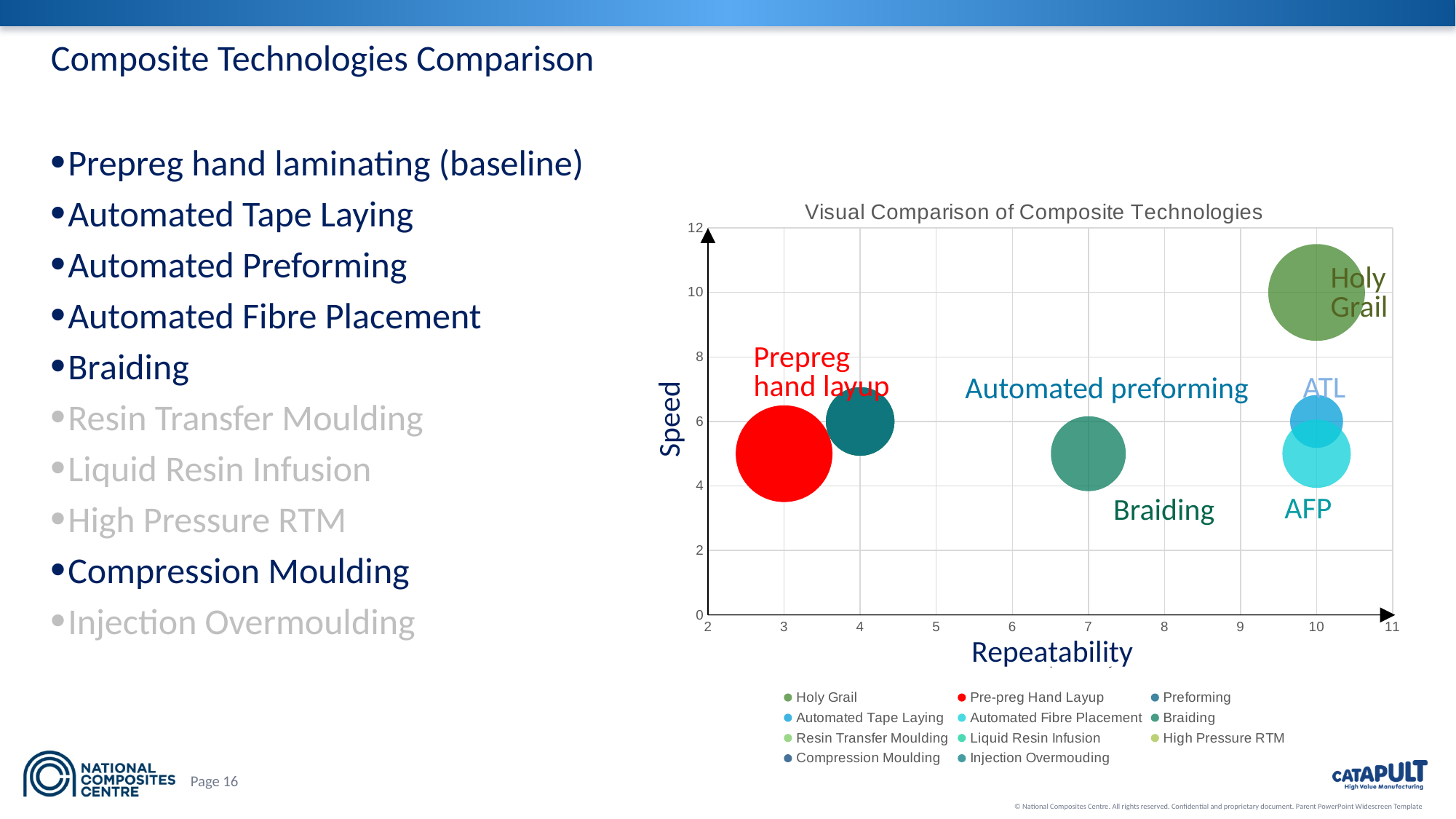
Which has the higher Repeatability value, Braiding or Prepreg hand layup? Braiding What is the Speed value for the Holy Grail bubble? 10 What is the title of the chart? Visual Comparison of Composite Technologies How many bubbles are plotted on the chart? 6 What is the label of the vertical axis of the chart? Speed Which technology has the lowest Repeatability value on the chart? Prepreg hand layup How many series does the chart legend list? 11 What is the Repeatability value for the Holy Grail bubble? 10 What kind of chart is shown on the slide? Bubble chart Which technology has the highest Speed value on the chart? Holy Grail Is the Speed value for Braiding greater or less than 8? less